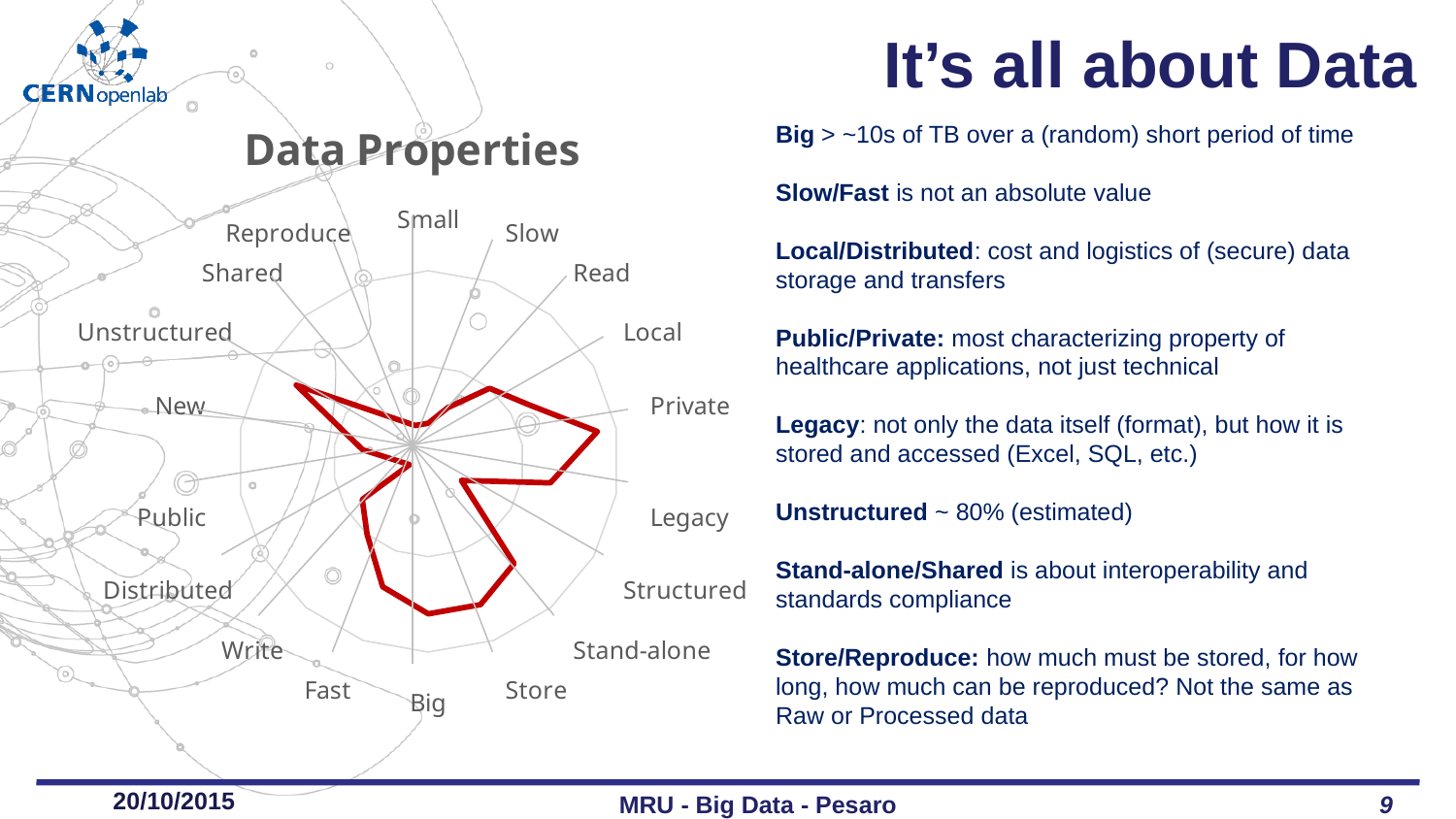
How many categories (axes) does the radar chart have? 18 What kind of chart is shown on the slide? Radar chart What is the title of the chart on the slide? Data Properties Which has the larger value on the radar chart, Private or Small? Private Which has the larger value on the radar chart, New or Local? Local Which category reaches the highest value on the radar chart? Private Which has the larger value on the radar chart, Store or Small? Store What colour is the data line plotted on the radar chart? Red